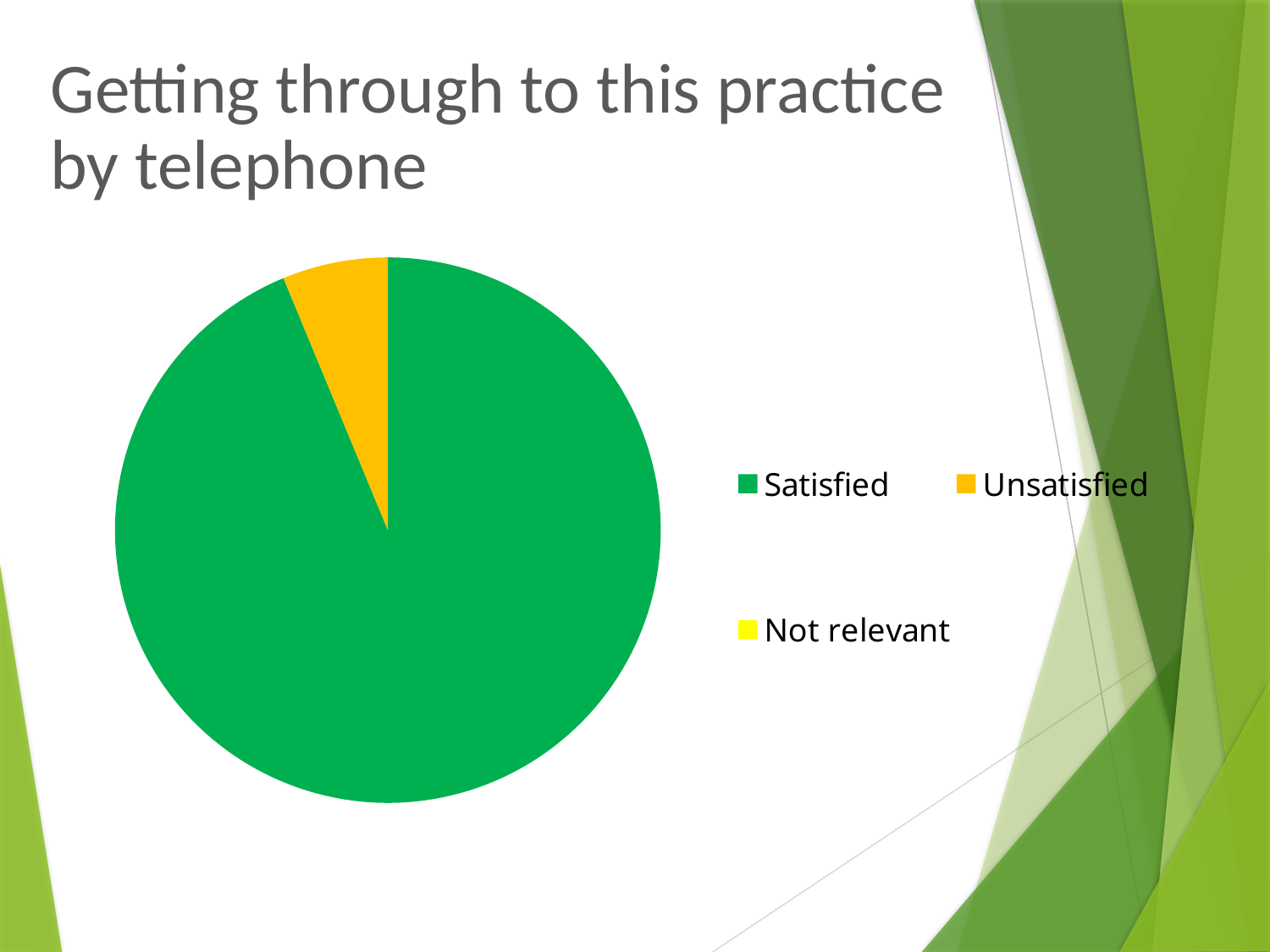
Which category has the largest slice of the pie? Satisfied How many entries does the chart's legend list? 3 Does the Satisfied slice take up more or less than half of the pie? More Which colour represents the Unsatisfied category in the legend? Orange Which is larger, the Satisfied slice or the Unsatisfied slice? Satisfied What kind of chart is shown on the slide? Pie chart Which legend entry is listed between Satisfied and Not relevant? Unsatisfied What is the title of the chart on the slide? Getting through to this practice by telephone